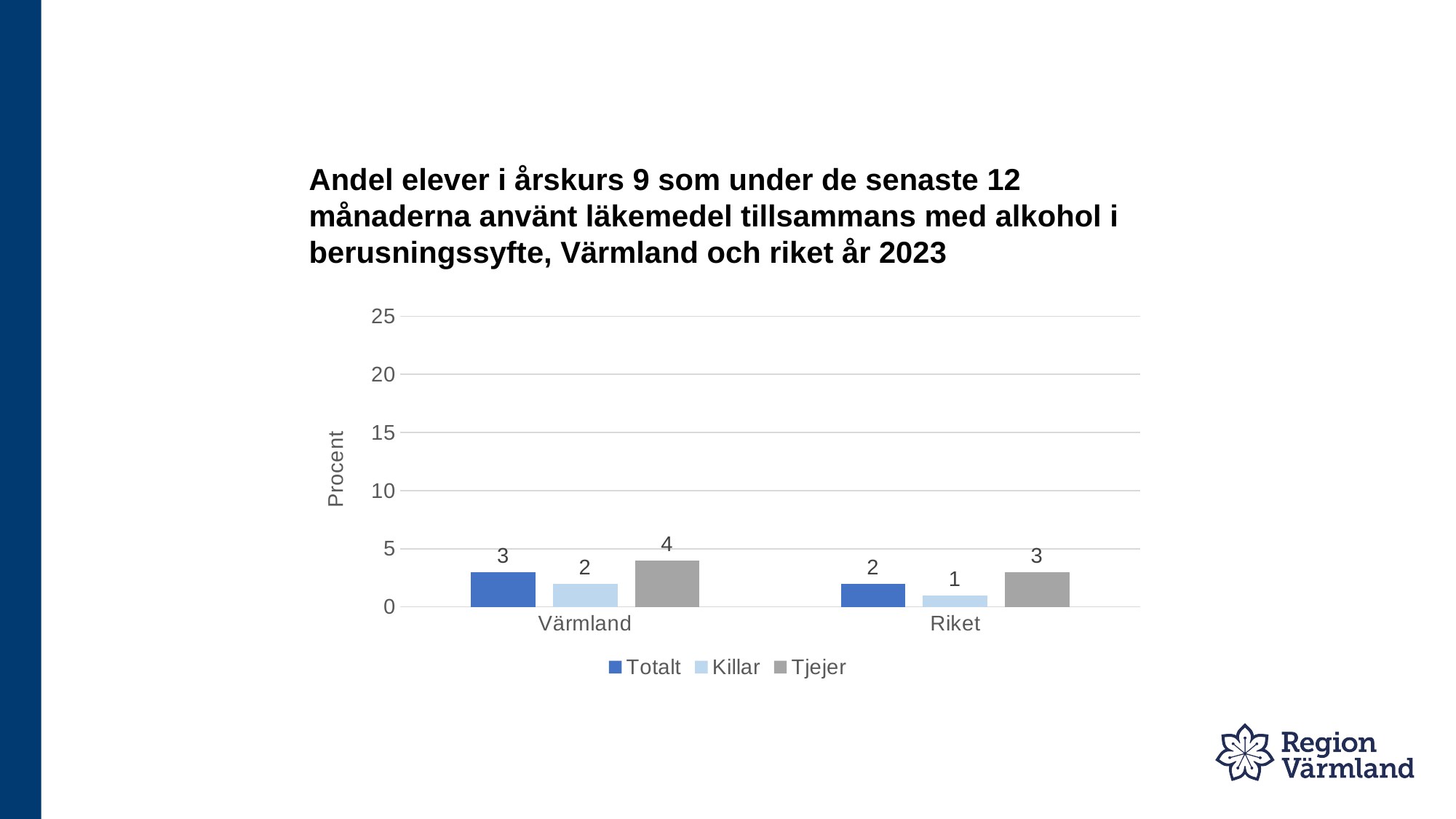
Is the value for Tjejer in Värmland greater or less than 5? less What kind of chart is shown on the slide? Bar chart What is the value for Tjejer in Värmland? 4 Which series has the lowest value in Riket? Killar Which series has the highest value in Värmland? Tjejer What is the value for Killar in Riket? 1 How many categories are shown on the x axis? 2 Which is larger, Totalt in Värmland or Totalt in Riket? Totalt in Värmland How many series does the legend list? 3 What is the value for Tjejer in Riket? 3 What is the value for Totalt in Värmland? 3 What is the difference between Tjejer and Killar in Värmland? 2